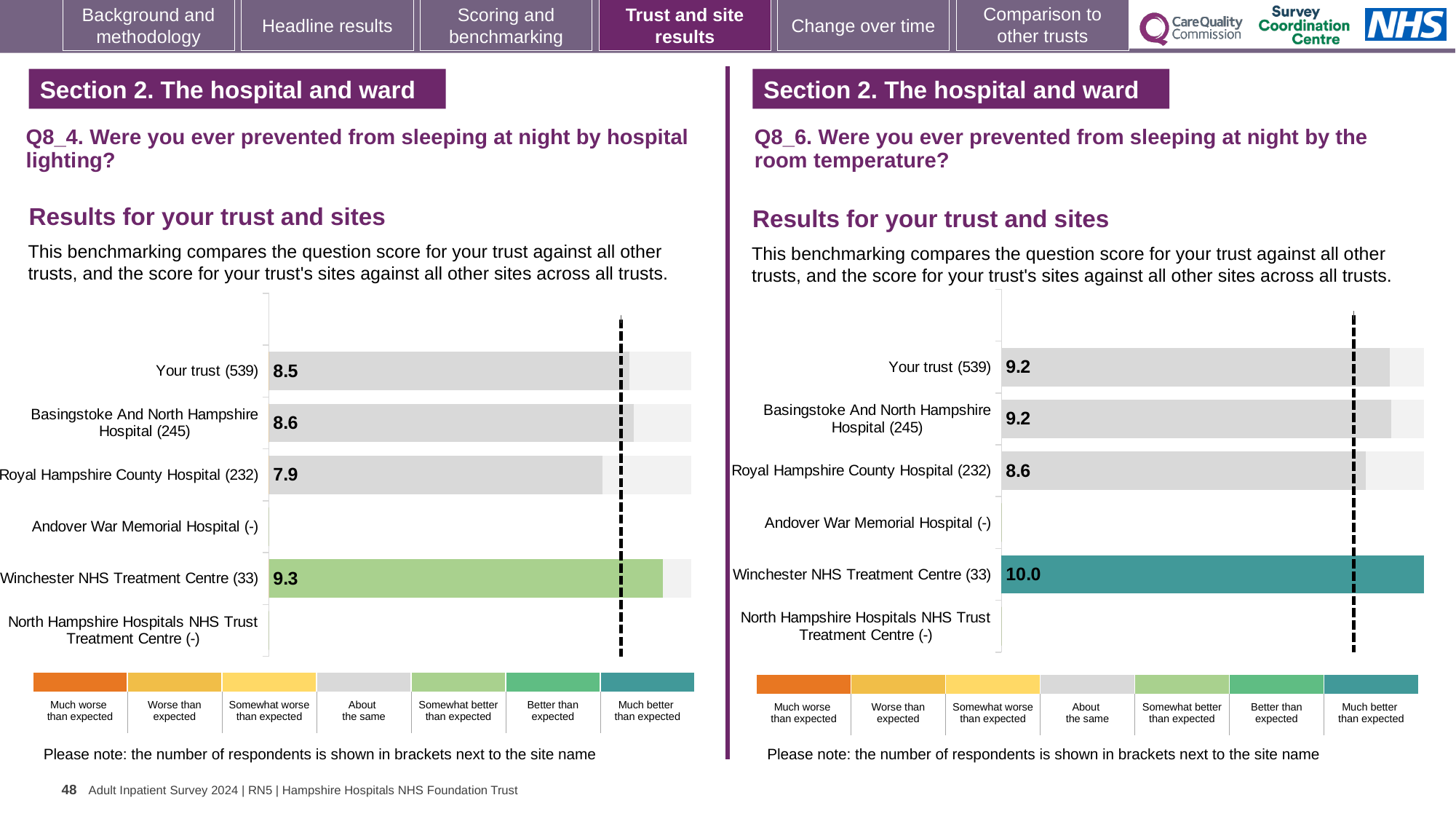
On the Q8_4 hospital lighting chart, which site has the highest score? Winchester NHS Treatment Centre (33) On the Q8_4 hospital lighting chart, what is the difference between the scores for Winchester NHS Treatment Centre (33) and Royal Hampshire County Hospital (232)? 1.4 On the Q8_6 room temperature chart, which site has the lowest plotted score? Royal Hampshire County Hospital (232) On the Q8_6 room temperature chart, what is the score for Basingstoke And North Hampshire Hospital (245)? 9.2 On the Q8_4 hospital lighting chart, which site has the lowest plotted score? Royal Hampshire County Hospital (232) What type of chart is used on the Q8_4 hospital lighting chart? Bar chart On the Q8_6 room temperature chart, what is the score for Winchester NHS Treatment Centre (33)? 10.0 Which is larger: the Your trust score on the Q8_4 hospital lighting chart or the Your trust score on the Q8_6 room temperature chart? Q8_6 room temperature (9.2) On the Q8_6 room temperature chart, what is the difference between the scores for Your trust (539) and Royal Hampshire County Hospital (232)? 0.6 On the Q8_4 hospital lighting chart, what is the score for Your trust (539)? 8.5 On the Q8_4 hospital lighting chart, what is the score for Royal Hampshire County Hospital (232)? 7.9 On the Q8_6 room temperature chart, how many sites have a plotted bar with a score? 4